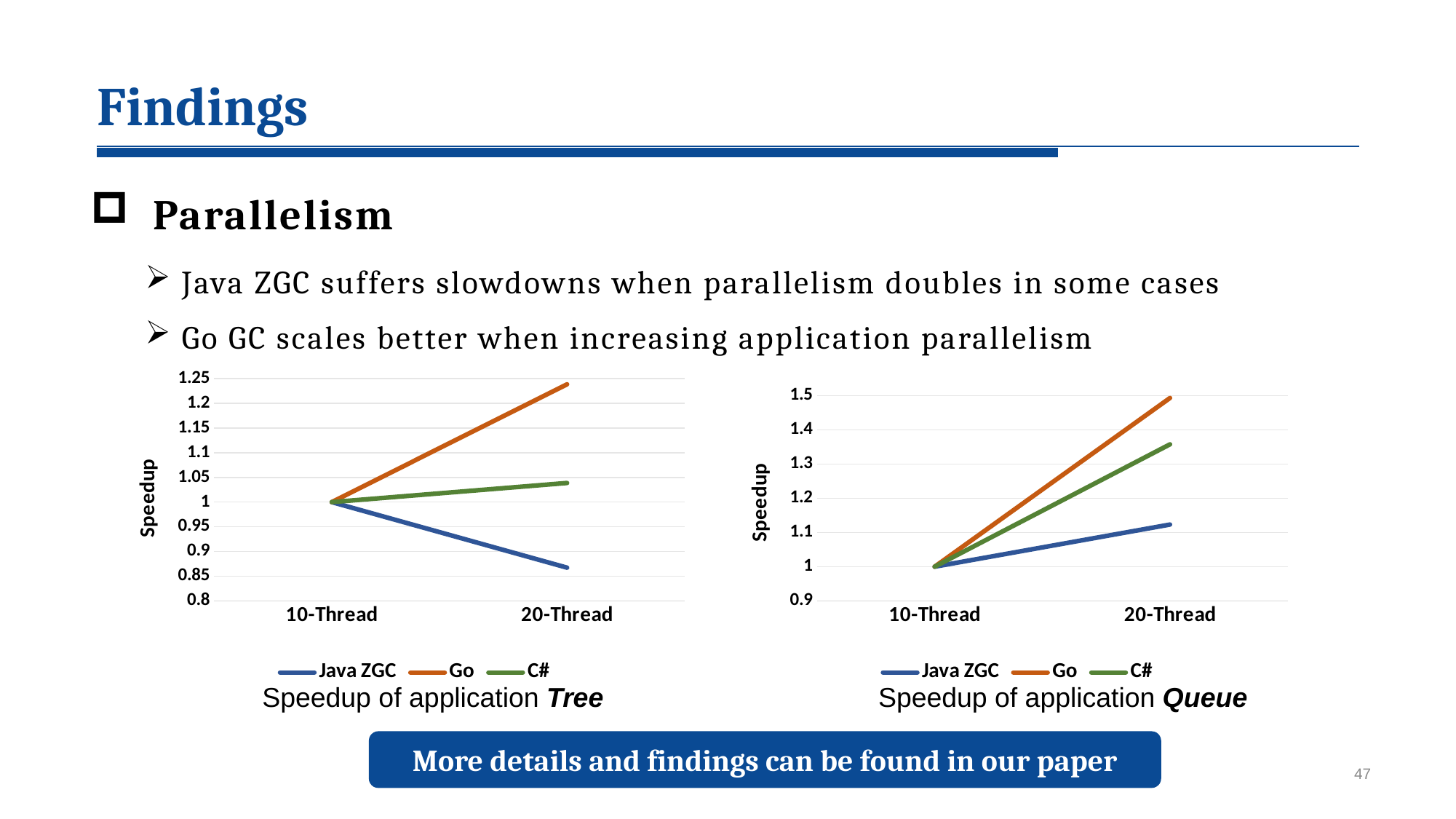
In the 'Speedup of application Queue' chart, which is larger at 20-Thread: the C# speedup or the Java ZGC speedup? C# In the 'Speedup of application Tree' chart, which series has the lowest speedup at 20-Thread? Java ZGC In the 'Speedup of application Queue' chart, does the Go line rise or fall from 10-Thread to 20-Thread? rise How many series does the legend of the 'Speedup of application Queue' chart list? 3 What kind of chart is the 'Speedup of application Tree' chart? line chart How many x-axis categories does the 'Speedup of application Tree' chart have? 2 In the 'Speedup of application Queue' chart, which series has the lowest speedup at 20-Thread? Java ZGC In the 'Speedup of application Tree' chart, does the Java ZGC line rise or fall from 10-Thread to 20-Thread? fall In the 'Speedup of application Queue' chart, is the Go speedup at 20-Thread greater or less than 1.4? greater In the 'Speedup of application Tree' chart, what is the speedup of Go at 10-Thread? 1 In the 'Speedup of application Tree' chart, which series has the highest speedup at 20-Thread? Go In the 'Speedup of application Tree' chart, is the Java ZGC speedup at 20-Thread greater or less than 0.9? less